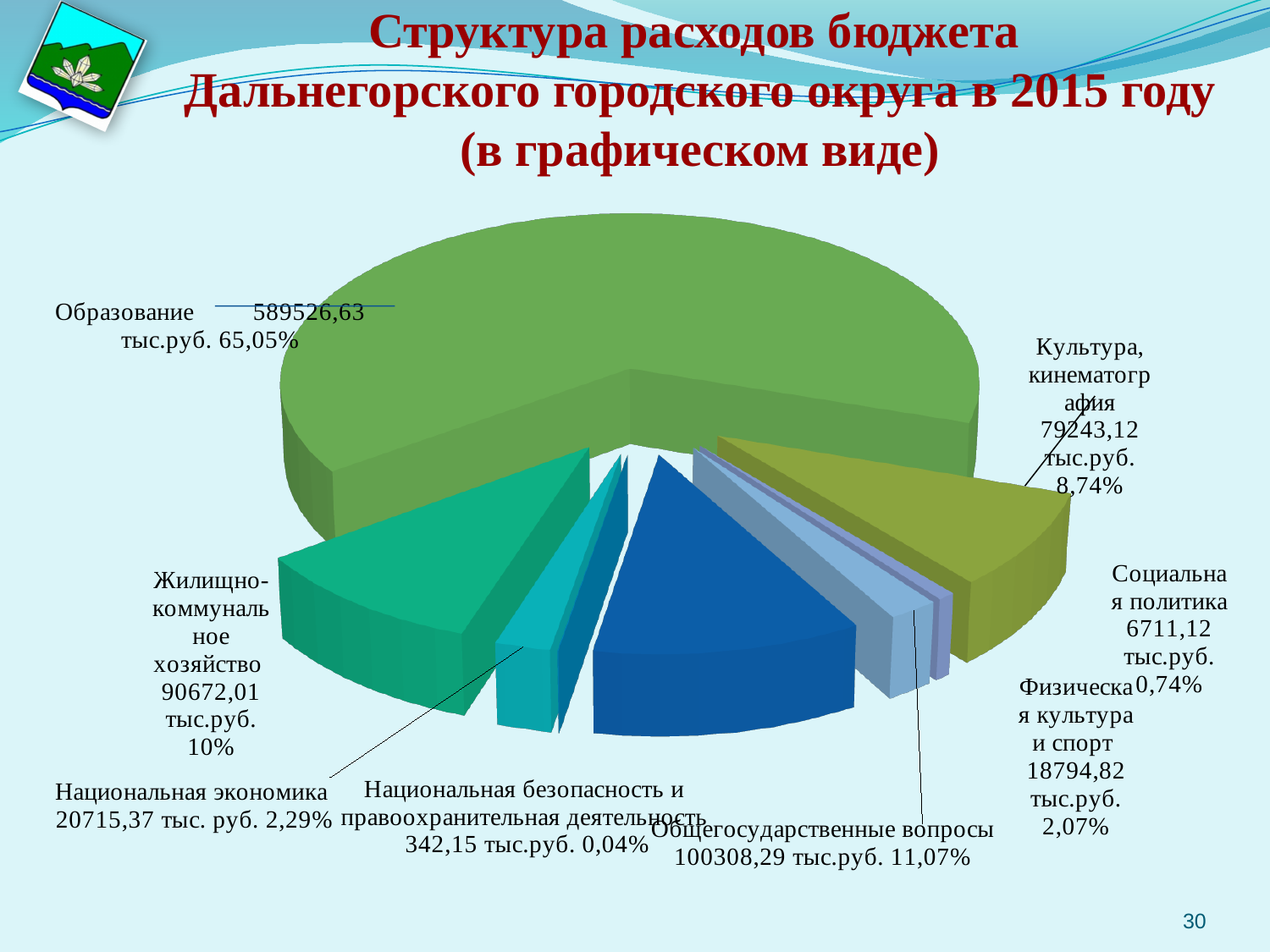
How many categories (slices) does the pie chart show? 8 Which category has the largest share of the pie? Образование Which is larger: Национальная экономика or Физическая культура и спорт? Национальная экономика Which category has the smallest share of the pie? Национальная безопасность и правоохранительная деятельность What percentage is shown for Жилищно-коммунальное хозяйство? 10% What percentage is shown for Социальная политика? 0,74% What value is shown for Общегосударственные вопросы? 100308,29 тыс.руб. What value is shown for Культура, кинематография? 79243,12 тыс.руб. What kind of chart is shown on the slide? Pie chart What is the difference in percentage points between Общегосударственные вопросы (11,07%) and Культура, кинематография (8,74%)? 2,33 What value is shown for Образование? 589526,63 тыс.руб. What share of the pie does Образование account for? 65,05%